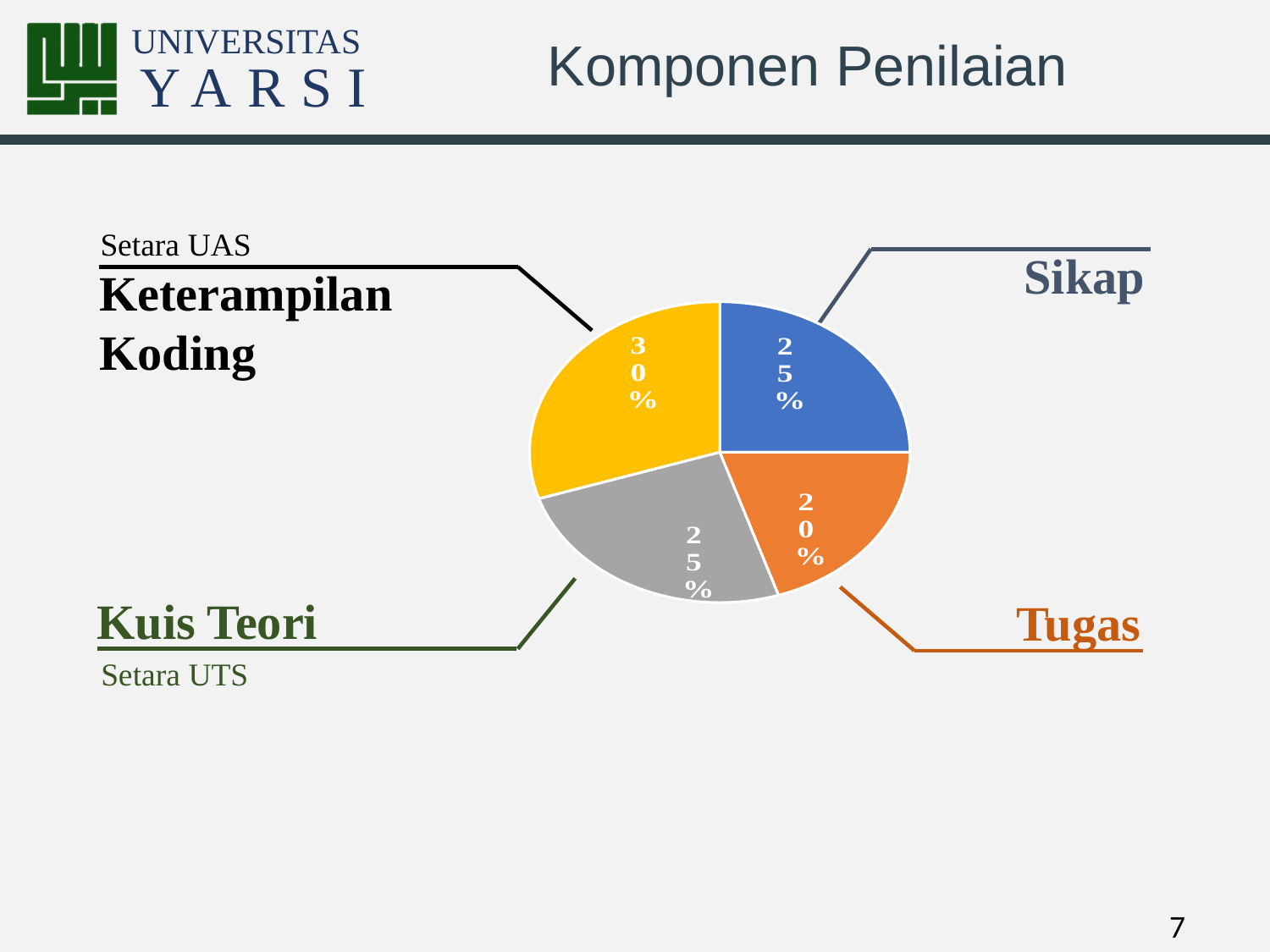
Which component has the largest share of the pie? Keterampilan Koding What colour is the Tugas slice of the pie chart? orange What is the title of the slide containing the pie chart? Komponen Penilaian What percentage does the Kuis Teori slice show? 25% How many slices does the pie chart have? 4 What percentage does the Keterampilan Koding slice show? 30% What percentage does the Tugas slice show? 20% What is the difference in percentage points between Keterampilan Koding and Tugas? 10 What percentage does the Sikap slice show? 25% What kind of chart is shown on the slide? pie chart Which component has the smallest share of the pie? Tugas Which is larger, the Sikap slice or the Tugas slice? Sikap